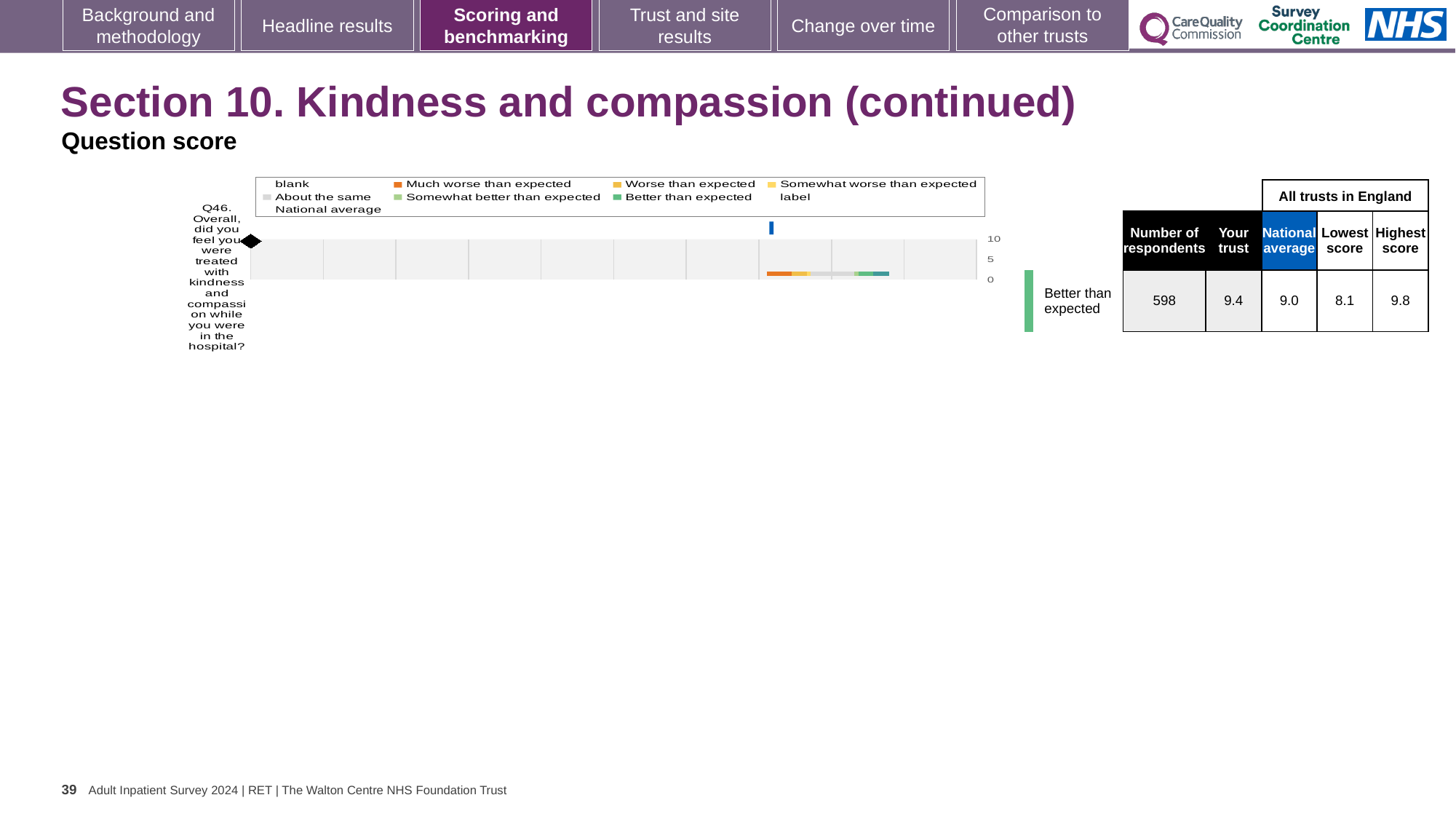
In the table beside the chart, what is the 'Your trust' score for Q46? 9.4 For Q46, which is larger: the 'Your trust' score or the national average? Your trust In the table beside the chart, what is the number of respondents for Q46? 598 Which question is plotted on the question score chart? Q46. Overall, did you feel you were treated with kindness and compassion while you were in the hospital? In the table beside the chart, what is the national average score for Q46? 9.0 In the table beside the chart, what is the highest score among all trusts in England for Q46? 9.8 What is the highest tick value shown on the chart's vertical axis? 10 For Q46, what is the difference between the highest and lowest scores among all trusts in England? 1.7 In the table beside the chart, what is the lowest score among all trusts in England for Q46? 8.1 How many survey questions are plotted on the question score chart? 1 For Q46, what is the difference between the 'Your trust' score and the national average? 0.4 What benchmark category is shown for Q46 next to the chart? Better than expected